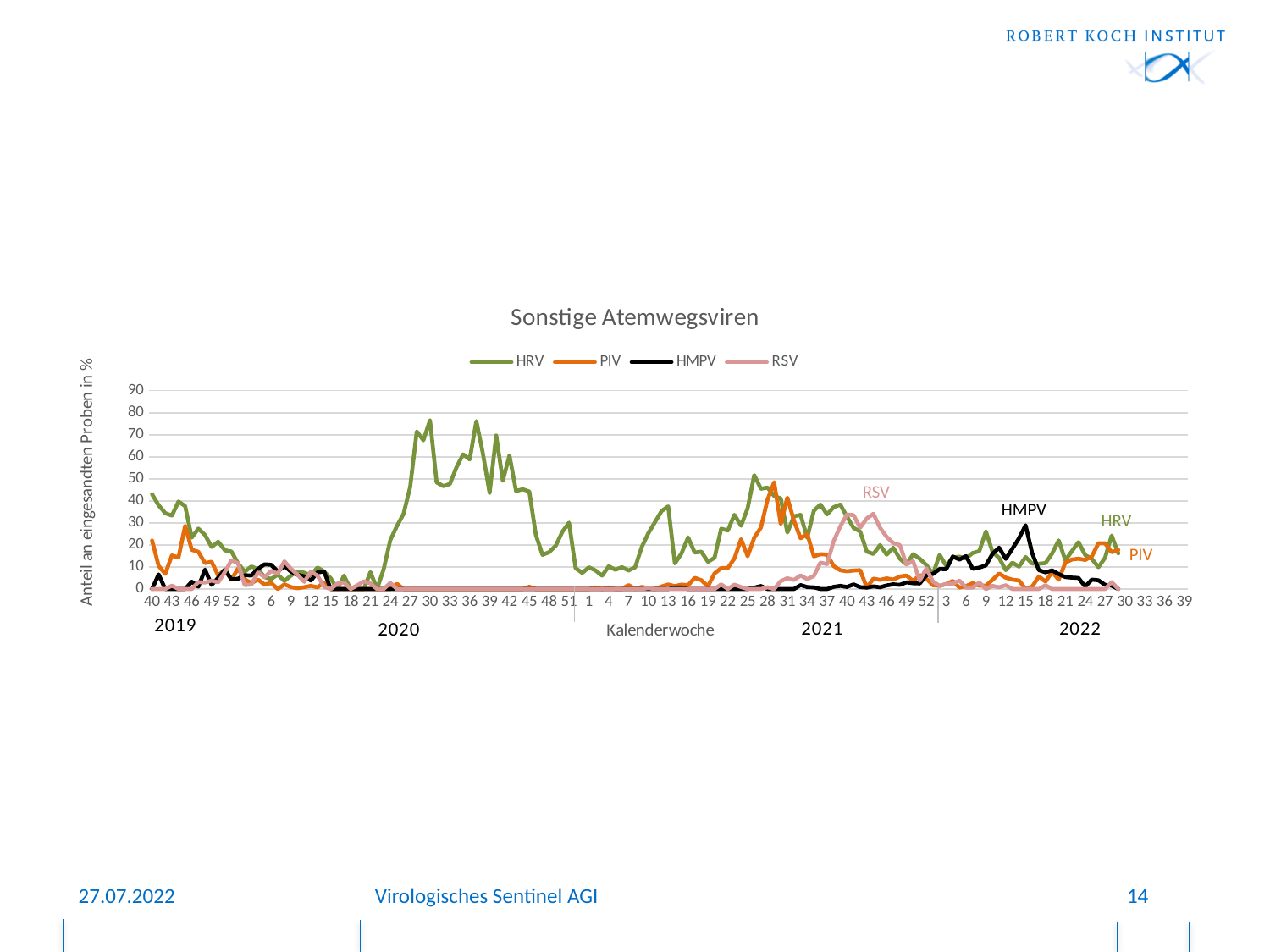
Which series reaches the highest value anywhere in the chart? HRV Is the peak value of HMPV in 2022 greater or less than 40? less What kind of chart is shown on the slide? line chart How many years are marked along the x axis of the chart? 4 Is the peak value of HMPV in 2022 greater or less than 20? greater Is the peak value of PIV in 2021 greater or less than 40? greater How many series does the legend of the chart list? 4 Which series are listed in the chart legend? HRV, PIV, HMPV, RSV What is the title of the chart? Sonstige Atemwegsviren What is the highest value shown on the y axis of the chart? 90